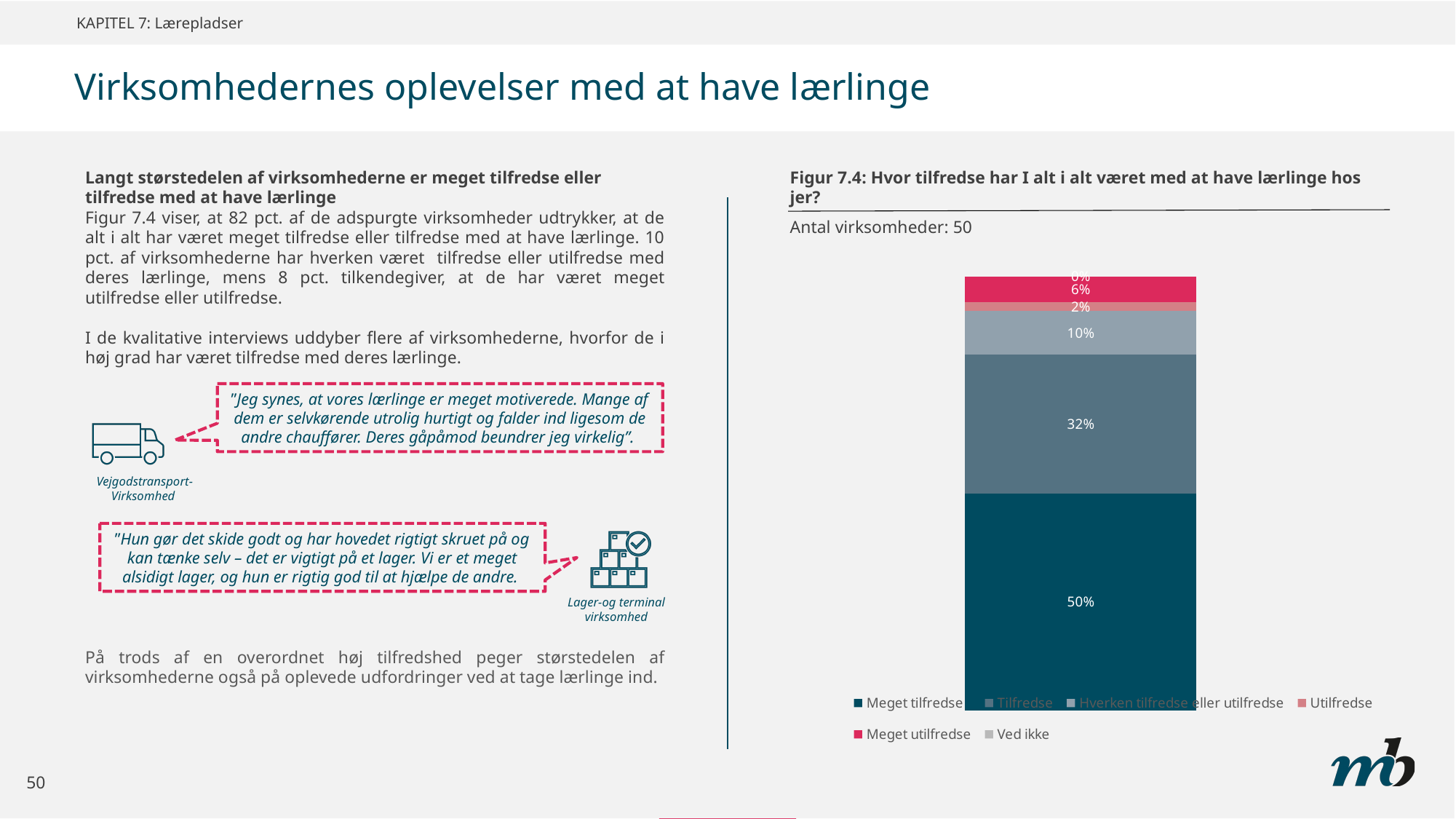
How many series does the legend of Figur 7.4 list? 6 What is the difference between the "Meget tilfredse" and "Tilfredse" shares in Figur 7.4? 18% How many companies does Figur 7.4 state were surveyed (Antal virksomheder)? 50 Which is larger in Figur 7.4: the share for "Meget utilfredse" or the share for "Utilfredse"? Meget utilfredse What percentage of companies answered "Utilfredse" in Figur 7.4? 2% What percentage of companies answered "Tilfredse" in Figur 7.4? 32% What percentage of companies answered "Meget utilfredse" in Figur 7.4? 6% What percentage of companies answered "Hverken tilfredse eller utilfredse" in Figur 7.4? 10% What type of chart is shown in Figur 7.4? Stacked bar chart What percentage of companies answered "Meget tilfredse" in Figur 7.4? 50% Which response category has the largest share in Figur 7.4? Meget tilfredse Which response category has the smallest share in Figur 7.4? Ved ikke